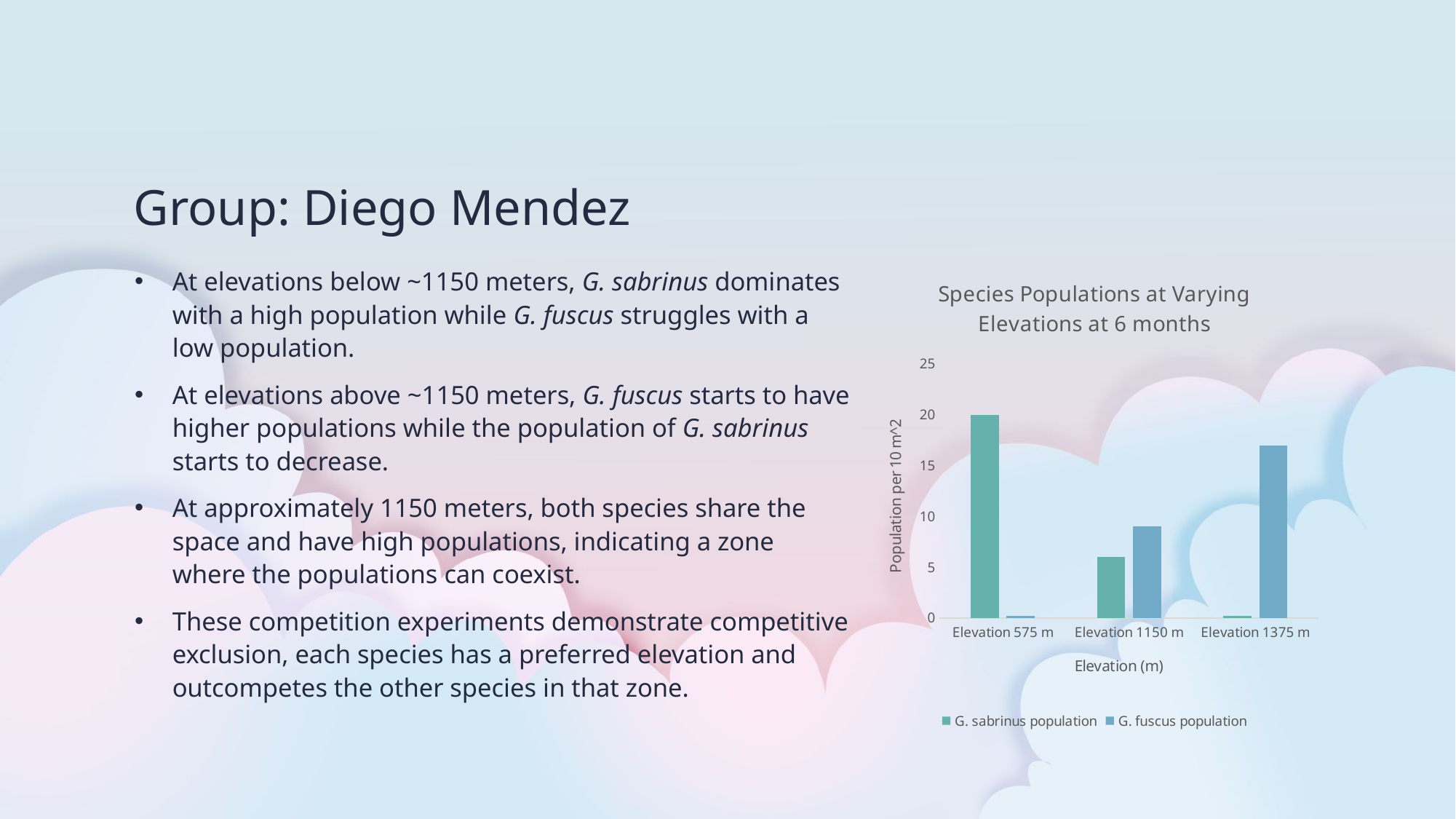
At which elevation is the G. fuscus population lowest? Elevation 575 m Is the G. fuscus population at Elevation 1375 m greater or less than 15? greater At Elevation 1150 m, which species has the larger population, G. sabrinus or G. fuscus? G. fuscus How many elevation categories are shown on the x axis of the chart? 3 Is the G. sabrinus population at Elevation 1150 m greater or less than 10? less How many series does the legend of the chart list? 2 What kind of chart is shown on the slide? Bar chart Does the G. fuscus population rise or fall as elevation increases along the x axis? Rise What is the title of the chart? Species Populations at Varying Elevations at 6 months At which elevation is the G. sabrinus population highest? Elevation 575 m Does the G. sabrinus population rise or fall as elevation increases along the x axis? Fall At which elevation is the G. fuscus population highest? Elevation 1375 m